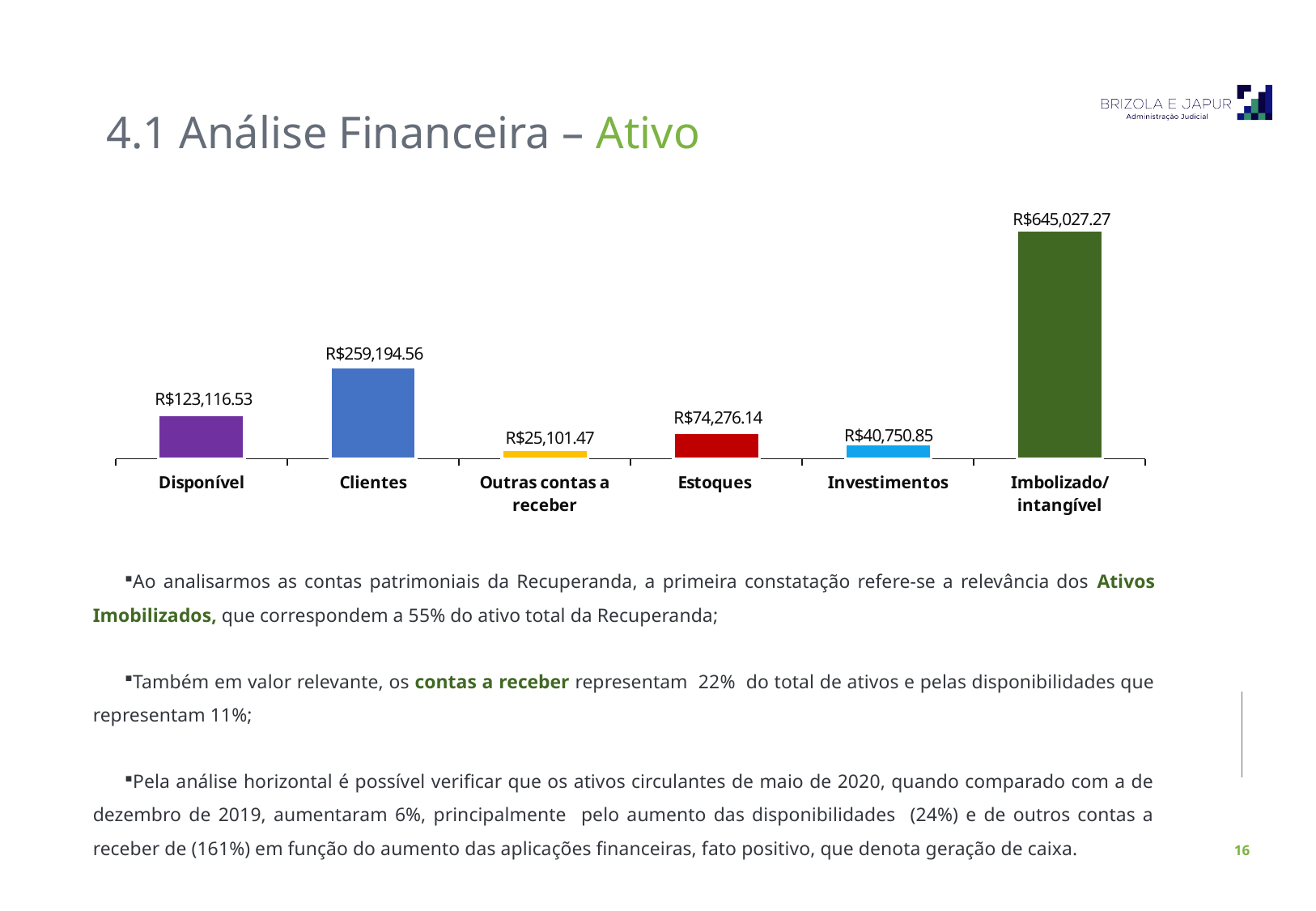
How many categories are shown in the chart? 6 Which is larger, the value for Estoques or the value for Investimentos? Estoques What is the value for Estoques? R$74,276.14 What is the value for Investimentos? R$40,750.85 What is the difference between the values for Clientes and Disponível? R$136,078.03 What is the value for Disponível? R$123,116.53 Which category has the highest value? Imbolizado/intangível Which category has the lowest value? Outras contas a receber What kind of chart is shown on the slide? Bar chart What is the value for Outras contas a receber? R$25,101.47 What is the value for Imobilizado/intangível? R$645,027.27 What is the value for Clientes? R$259,194.56